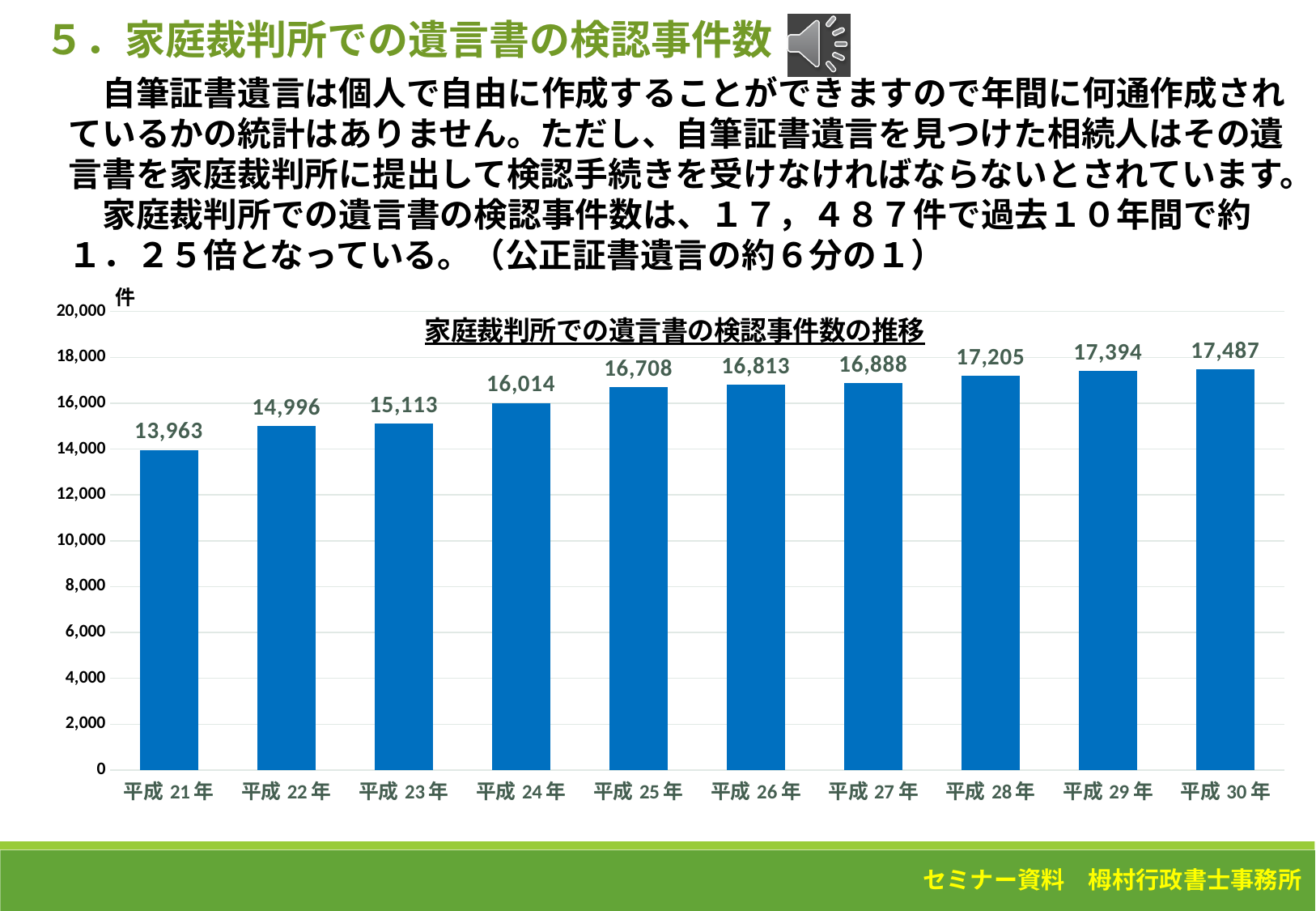
What is the value for 平成 25 年? 16,708 Which is larger, the value for 平成 22 年 or the value for 平成 28 年? 平成 28 年 What is the value for 平成 30 年? 17,487 What is the difference between the values for 平成 30 年 and 平成 21 年? 3,524 What is the difference between the values for 平成 24 年 and 平成 23 年? 901 Do the values rise or fall from 平成 21 年 to 平成 30 年? rise Which year has the highest value? 平成 30 年 Which year has the lowest value? 平成 21 年 How many years are shown on the x axis? 10 What kind of chart is shown? bar chart What is the value for 平成 21 年? 13,963 Is the value for 平成 27 年 greater or less than 16,000? greater